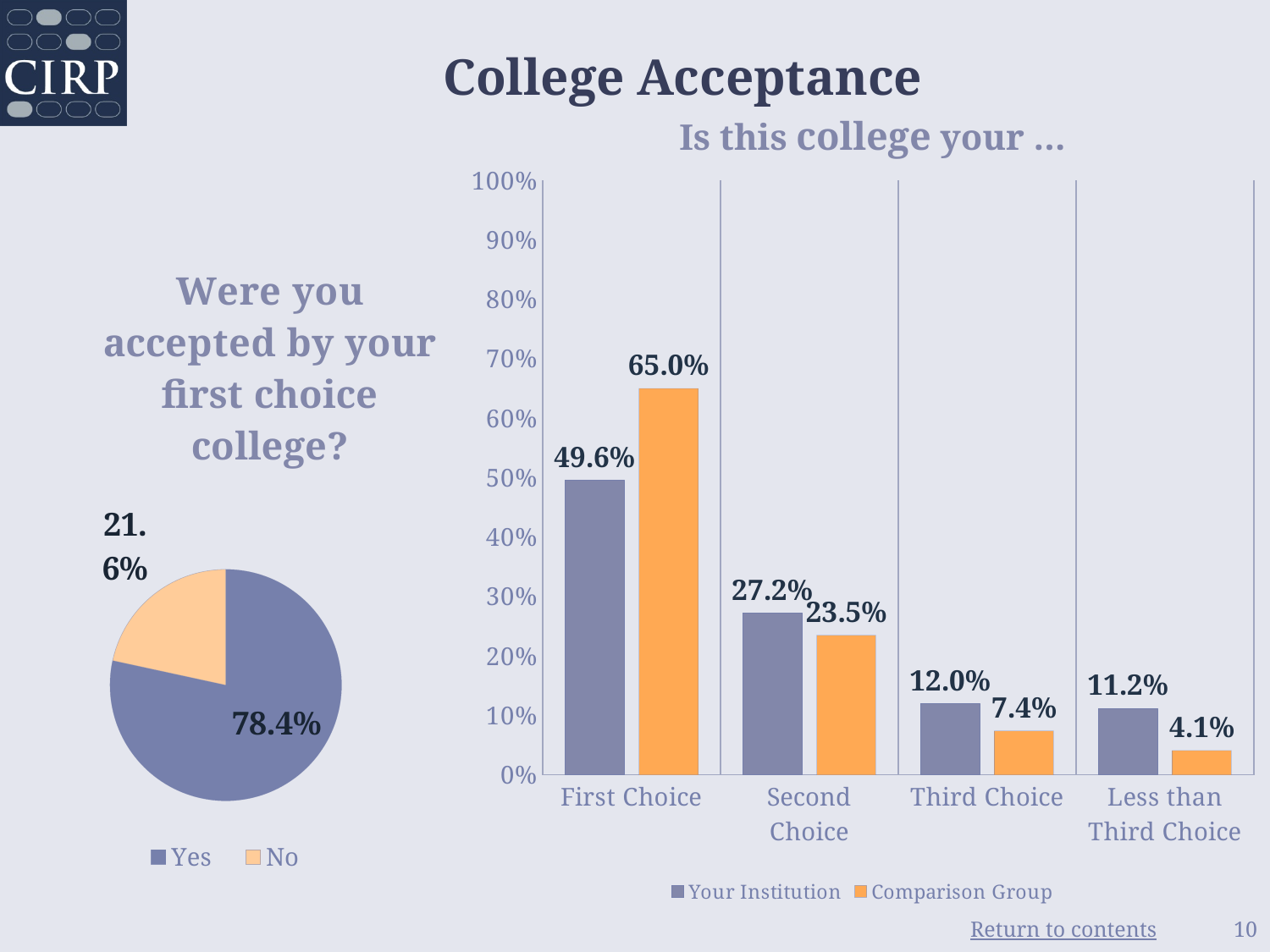
In the 'Is this college your ...' chart, which category has the lowest Your Institution value? Less than Third Choice How many categories are shown on the x axis of the 'Is this college your ...' chart? 4 What kind of chart is the 'Is this college your ...' chart? bar chart In the 'Is this college your ...' chart, what is the difference between the Comparison Group and Your Institution values for First Choice? 15.4% In the 'Is this college your ...' chart, what is the value for Your Institution for First Choice? 49.6% In the 'Were you accepted by your first choice college?' pie chart, what share of respondents answered Yes? 78.4% How many series does the legend of the 'Is this college your ...' chart list? 2 What kind of chart is the 'Were you accepted by your first choice college?' chart? pie chart In the 'Were you accepted by your first choice college?' pie chart, what is the value for No? 21.6% In the 'Is this college your ...' chart, which is larger for Second Choice: Your Institution or Comparison Group? Your Institution In the 'Is this college your ...' chart, what is the value for Comparison Group for Less than Third Choice? 4.1% In the 'Is this college your ...' chart, which category has the highest Comparison Group value? First Choice